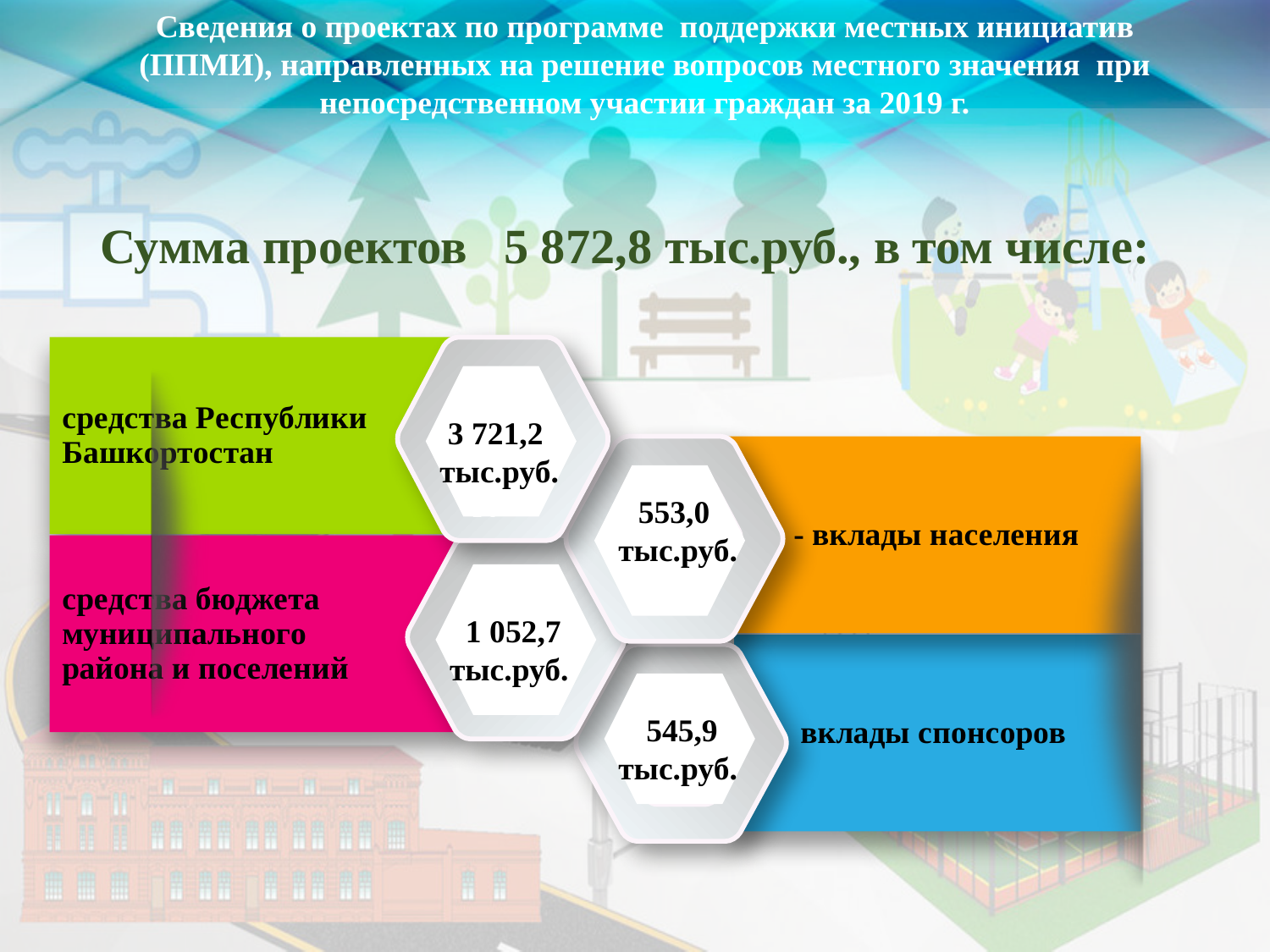
What colour is the block for вклады спонсоров? Blue Which funding source has the largest value? средства Республики Башкортостан How many funding sources are shown in the diagram? 4 What is the value shown for средства Республики Башкортостан? 3 721,2 тыс.руб. What is the value shown for вклады населения? 553,0 тыс.руб. What is the value shown for средства бюджета муниципального района и поселений? 1 052,7 тыс.руб. Which funding source has the smallest value? вклады спонсоров Which is larger: вклады населения or вклады спонсоров? вклады населения What is the value shown for вклады спонсоров? 545,9 тыс.руб. What is the total sum of projects (Сумма проектов) stated on the slide? 5 872,8 тыс.руб. What is the difference between вклады населения and вклады спонсоров? 7,1 тыс.руб. What is the difference between средства Республики Башкортостан and средства бюджета муниципального района и поселений? 2 668,5 тыс.руб.